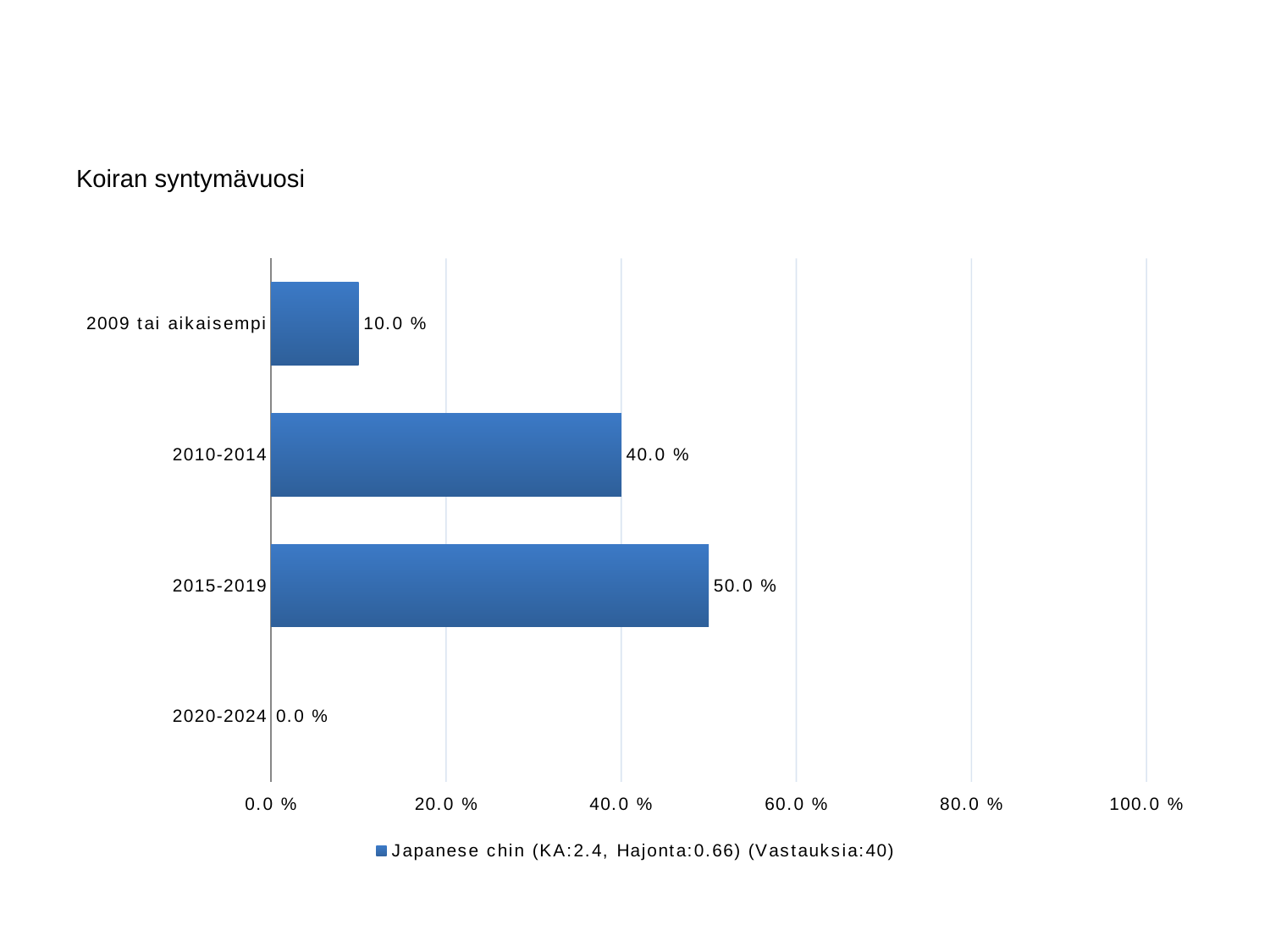
What is the value for 2020-2024? 0.0 % What is the value for 2009 tai aikaisempi? 10.0 % Which is larger, the value for 2010-2014 or the value for 2009 tai aikaisempi? 2010-2014 Which category has the lowest value? 2020-2024 What is the title of the chart? Koiran syntymävuosi Which category has the highest value? 2015-2019 How many series does the legend list? 1 What is the value for 2010-2014? 40.0 % How many categories are shown on the chart? 4 Is the value for 2015-2019 greater or less than 40.0 %? greater What is the difference between the values for 2015-2019 and 2010-2014? 10.0 % What kind of chart is shown? bar chart